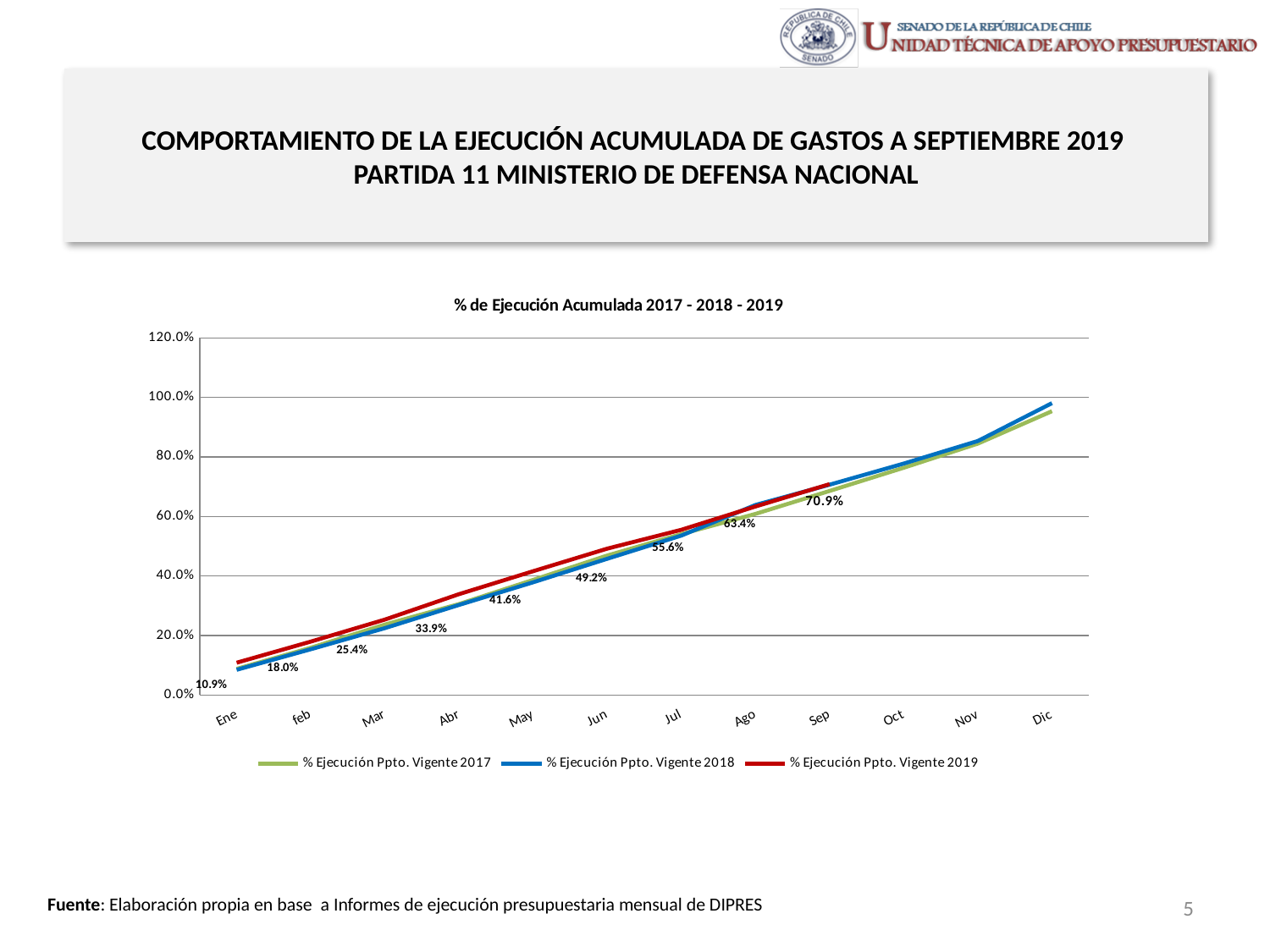
What is the value of % Ejecución Ppto. Vigente 2019 for Ene? 10.9% What type of chart is shown on the slide? line chart Does the % Ejecución Ppto. Vigente 2019 series rise or fall from Ene to Sep? rise How many series does the legend list? 3 What is the value of % Ejecución Ppto. Vigente 2019 for May? 41.6% What is the title of the chart? % de Ejecución Acumulada 2017 - 2018 - 2019 What is the difference between the % Ejecución Ppto. Vigente 2019 values for Sep and Ago? 7.5% What is the value of % Ejecución Ppto. Vigente 2019 for Jul? 55.6% Which colour is used for the % Ejecución Ppto. Vigente 2019 line? red Is the value of % Ejecución Ppto. Vigente 2018 for Dic greater or less than 80.0%? greater What is the value of % Ejecución Ppto. Vigente 2019 for Sep? 70.9% How many months are shown on the x axis? 12